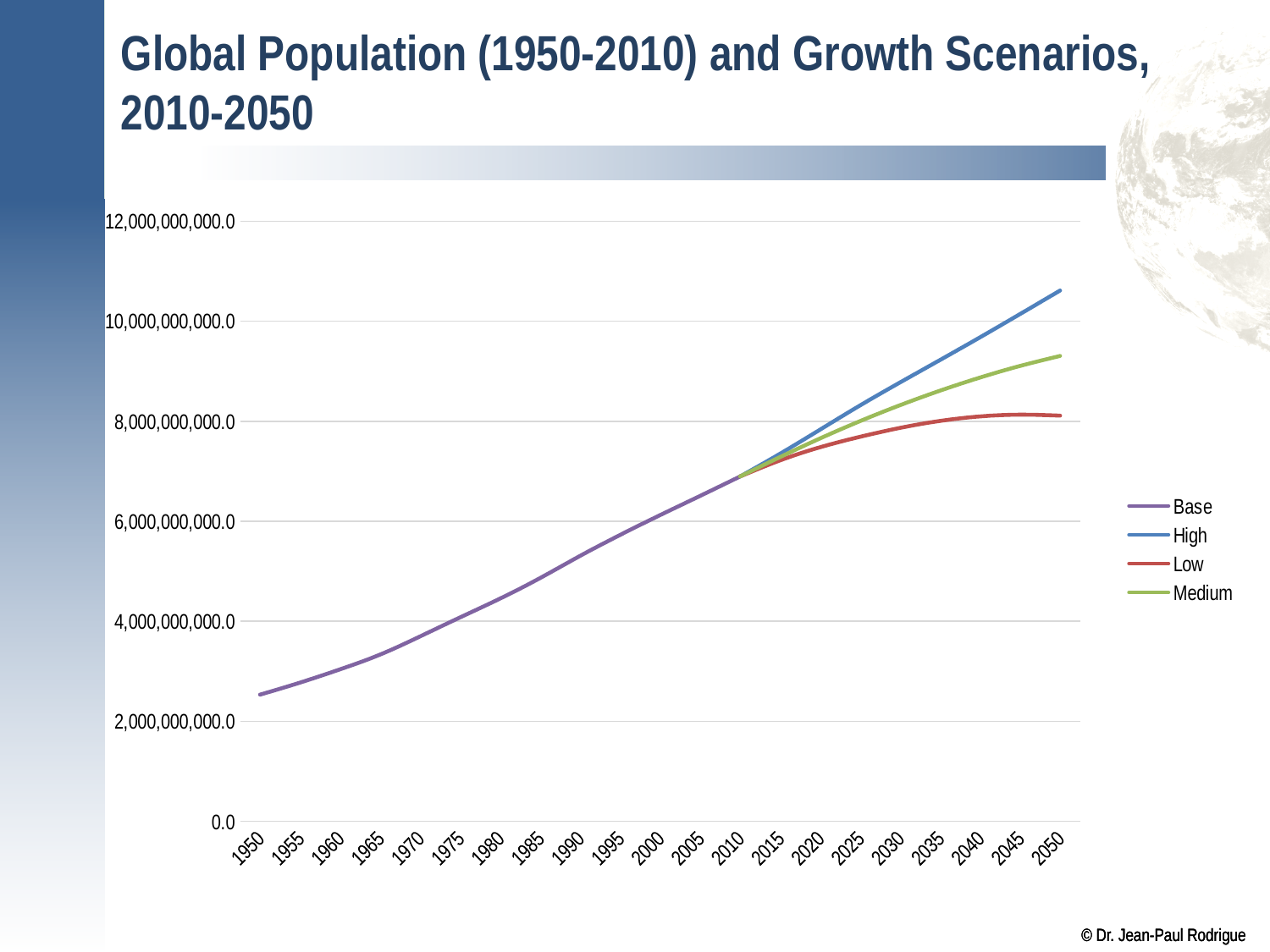
What kind of chart is shown on the slide? line chart Is the value for the High scenario in 2050 greater or less than 10,000,000,000.0? greater How many year labels are shown along the x axis? 21 Which scenario has the lowest value in 2050? Low What colour is the line for the Low scenario? red Is the value for the Base series in 1950 greater or less than 2,000,000,000.0? greater Which scenario has the highest value in 2050? High In 2050, which is larger, the High scenario or the Medium scenario? High Does the Base series rise or fall from 1950 to 2010? rise What is the title of the chart? Global Population (1950-2010) and Growth Scenarios, 2010-2050 Is the value for the Medium scenario in 2050 greater or less than 10,000,000,000.0? less How many series does the legend list? 4